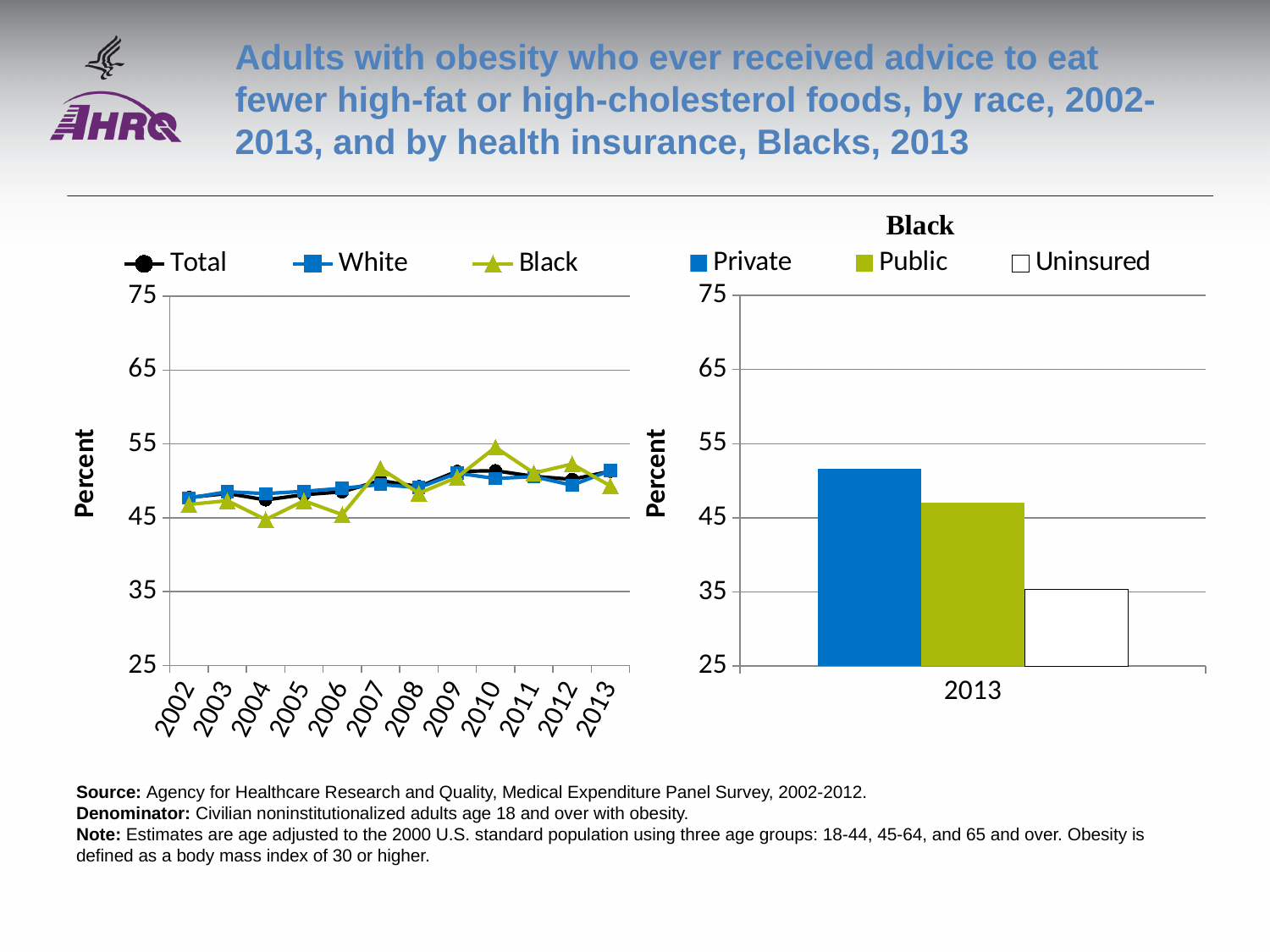
In the left-hand line chart, is the value for Black in 2007 greater or less than 45? greater How many series does the legend of the right-hand chart (Black, 2013) list? 3 In the right-hand chart (Black, 2013), which is larger, the value for Public or the value for Uninsured? Public How many series does the legend of the left-hand line chart list? 3 In the right-hand chart (Black, 2013), is the value for Uninsured greater or less than 45? less In the right-hand chart (Black, 2013), is the value for Private greater or less than 45? greater In the right-hand chart (Black, 2013), which insurance group has the highest value? Private In the right-hand chart (Black, 2013), which insurance group has the lowest value? Uninsured What kind of chart is the left-hand chart showing Total, White and Black from 2002 to 2013? line chart In the left-hand line chart, does the Total series generally rise or fall from 2002 to 2013? rise How many years are shown on the x axis of the left-hand line chart? 12 What kind of chart is the right-hand chart (Black, 2013)? bar chart